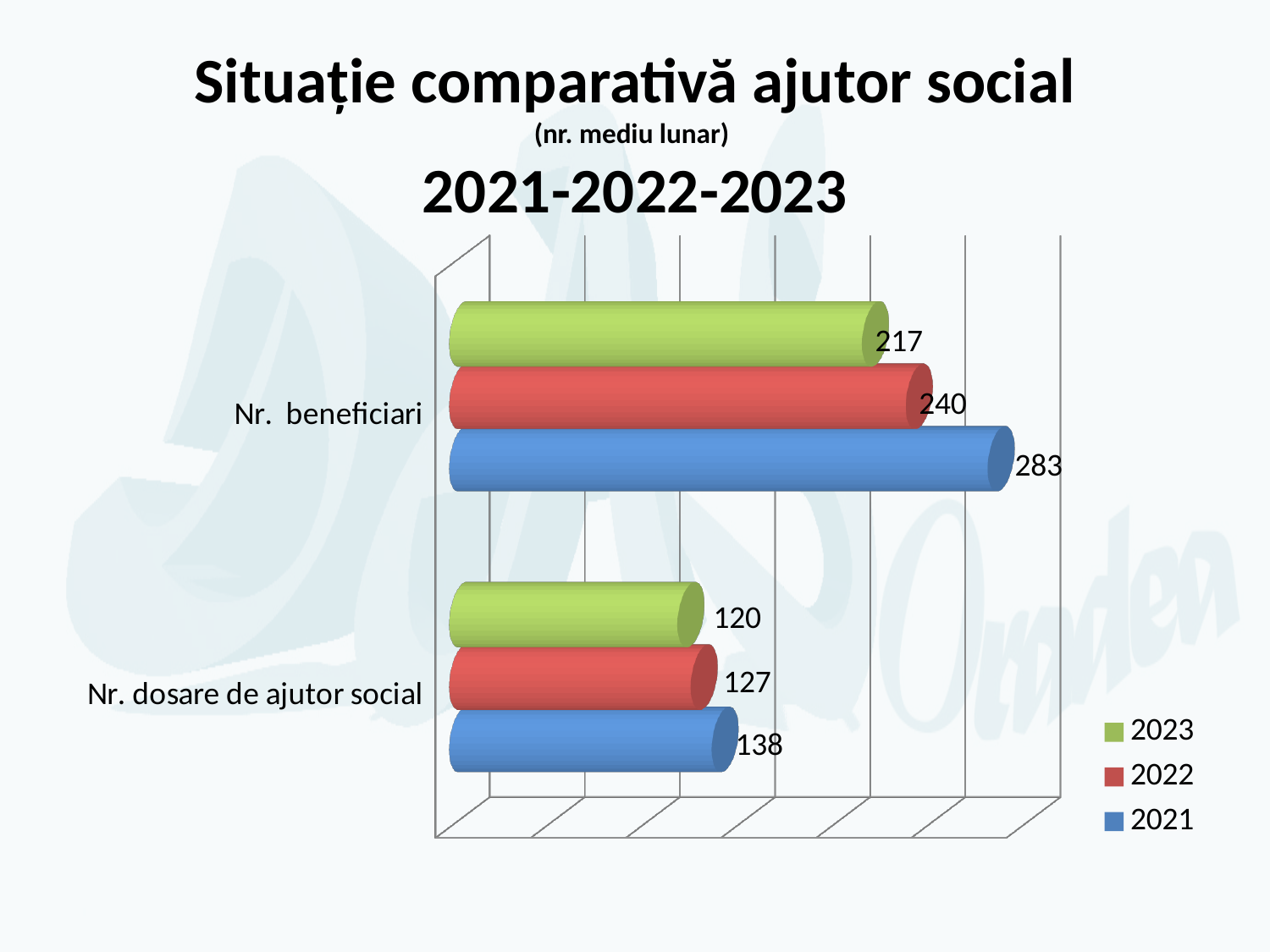
Which year has the highest value for Nr. beneficiari? 2021 What is the value for Nr. dosare de ajutor social in 2022? 127 What is the value for Nr. beneficiari in 2022? 240 What kind of chart is shown on the slide? Bar chart What is the value for Nr. beneficiari in 2021? 283 Which year has the lowest value for Nr. dosare de ajutor social? 2023 What is the value for Nr. dosare de ajutor social in 2023? 120 What is the difference between the 2021 and 2023 values for Nr. beneficiari? 66 Which colour represents the year 2022 in the chart? Red How many series does the legend list? 3 Which is larger: Nr. beneficiari in 2023 or Nr. dosare de ajutor social in 2021? Nr. beneficiari in 2023 What is the difference between the 2021 and 2022 values for Nr. dosare de ajutor social? 11